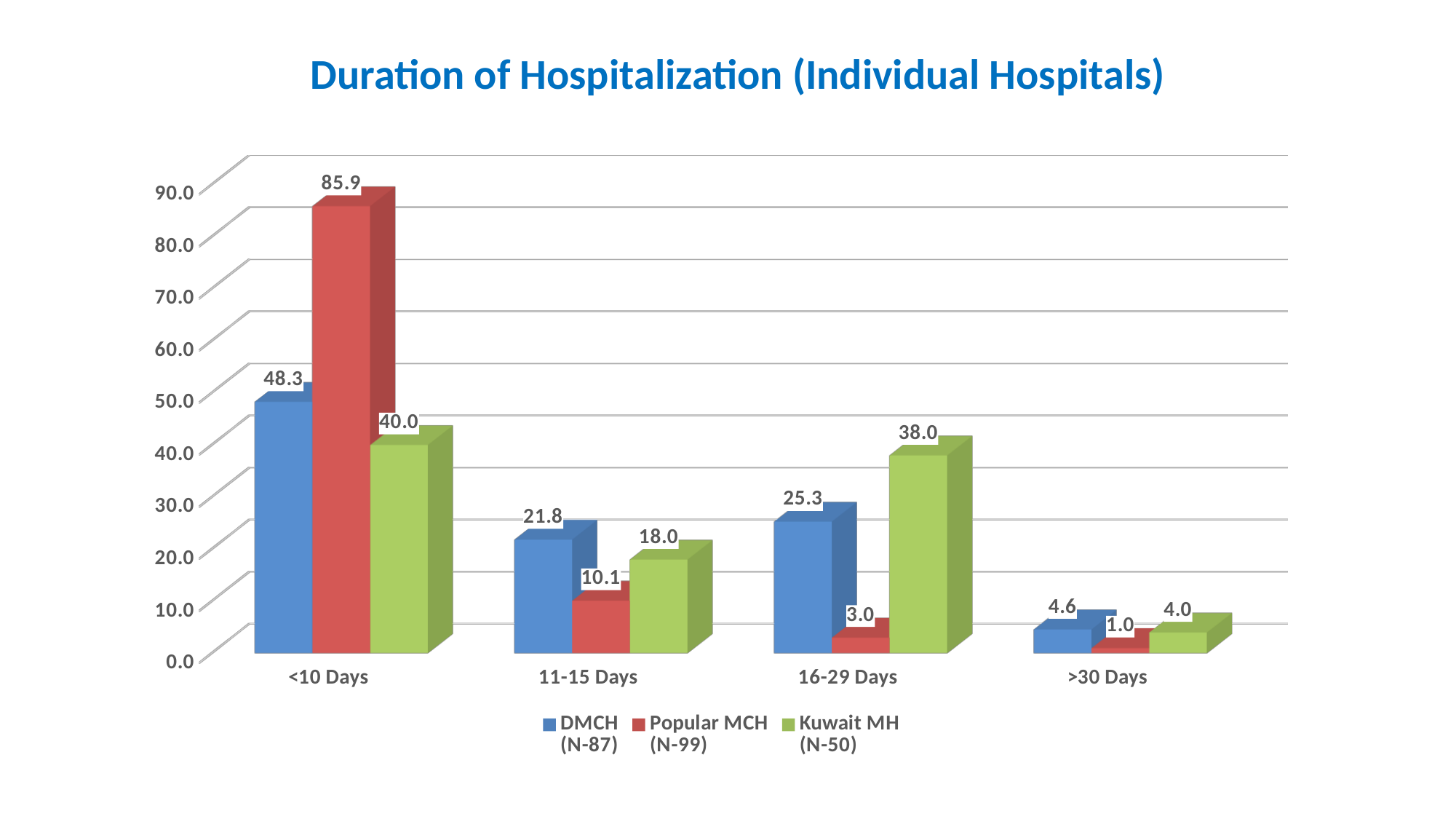
What is the value for DMCH in the 11-15 Days category? 21.8 What is the value for Kuwait MH in the 16-29 Days category? 38.0 Is the value for Popular MCH in the <10 Days category greater or less than 80.0? greater How many series does the legend list? 3 In the 16-29 Days category, which is larger: the DMCH value or the Kuwait MH value? Kuwait MH What is the title of the chart? Duration of Hospitalization (Individual Hospitals) What kind of chart is shown on the slide? Bar chart What is the value for Popular MCH in the <10 Days category? 85.9 Which category has the lowest value for Popular MCH? >30 Days Which category has the highest value for Kuwait MH? <10 Days How many duration categories are shown on the x axis? 4 What is the difference between the Popular MCH and DMCH values in the <10 Days category? 37.6